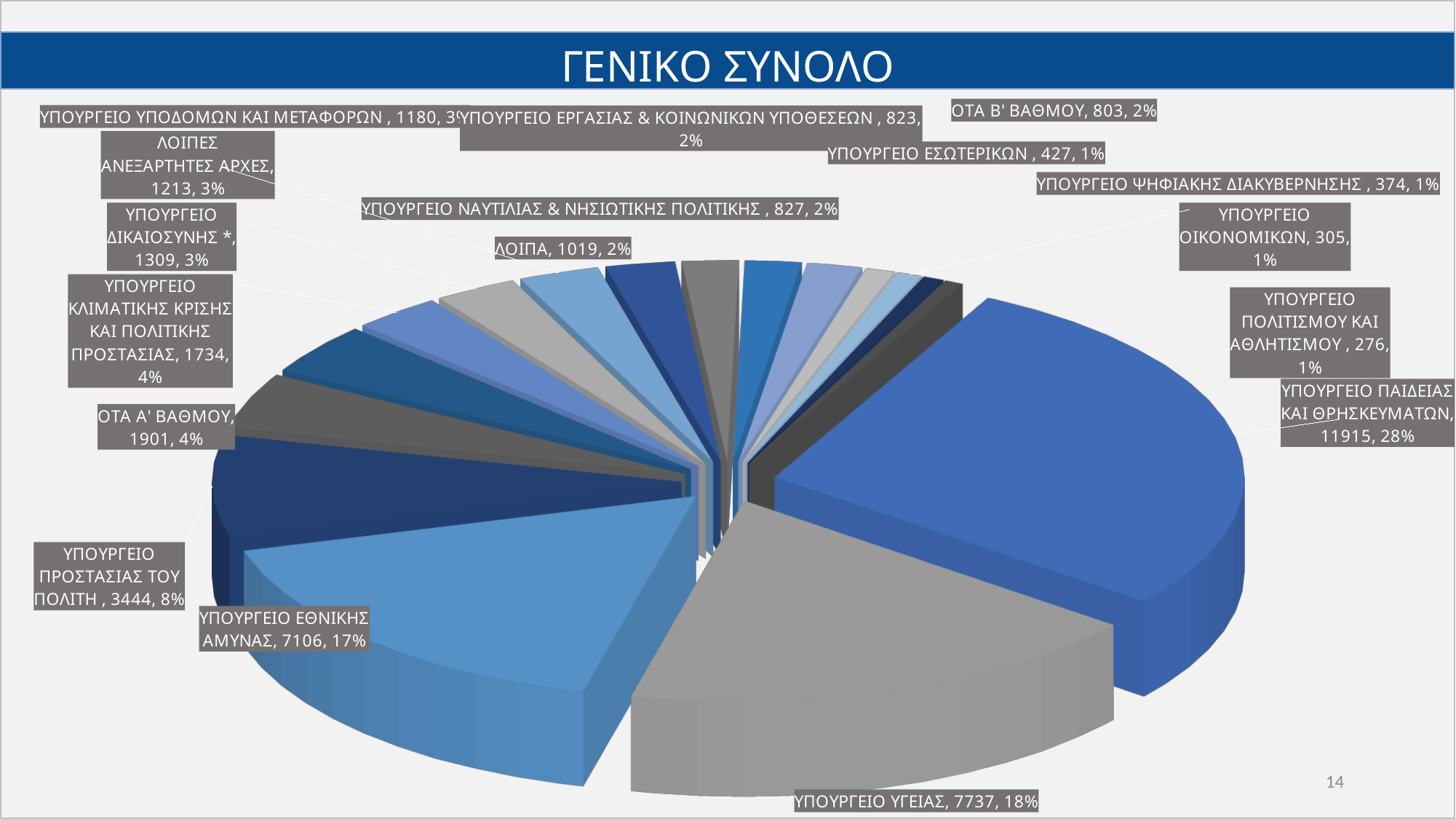
What share of the pie does ΥΠΟΥΡΓΕΙΟ ΠΡΟΣΤΑΣΙΑΣ ΤΟΥ ΠΟΛΙΤΗ represent? 8% What is the title of the slide? ΓΕΝΙΚΟ ΣΥΝΟΛΟ What type of chart is shown on the slide? pie chart Which is larger, the value for ΥΠΟΥΡΓΕΙΟ ΕΣΩΤΕΡΙΚΩΝ or the value for ΥΠΟΥΡΓΕΙΟ ΨΗΦΙΑΚΗΣ ΔΙΑΚΥΒΕΡΝΗΣΗΣ? ΥΠΟΥΡΓΕΙΟ ΕΣΩΤΕΡΙΚΩΝ What is the value for ΥΠΟΥΡΓΕΙΟ ΥΓΕΙΑΣ? 7737 What is the difference between the values for ΥΠΟΥΡΓΕΙΟ ΥΓΕΙΑΣ and ΥΠΟΥΡΓΕΙΟ ΕΘΝΙΚΗΣ ΑΜΥΝΑΣ? 631 Which category has the largest slice of the pie? ΥΠΟΥΡΓΕΙΟ ΠΑΙΔΕΙΑΣ ΚΑΙ ΘΡΗΣΚΕΥΜΑΤΩΝ What is the value for ΟΤΑ Α' ΒΑΘΜΟΥ? 1901 What is the value for ΥΠΟΥΡΓΕΙΟ ΟΙΚΟΝΟΜΙΚΩΝ? 305 What share of the pie does ΥΠΟΥΡΓΕΙΟ ΠΑΙΔΕΙΑΣ ΚΑΙ ΘΡΗΣΚΕΥΜΑΤΩΝ represent? 28% What is the value for ΥΠΟΥΡΓΕΙΟ ΕΘΝΙΚΗΣ ΑΜΥΝΑΣ? 7106 Which category has the smallest slice of the pie? ΥΠΟΥΡΓΕΙΟ ΠΟΛΙΤΙΣΜΟΥ ΚΑΙ ΑΘΛΗΤΙΣΜΟΥ